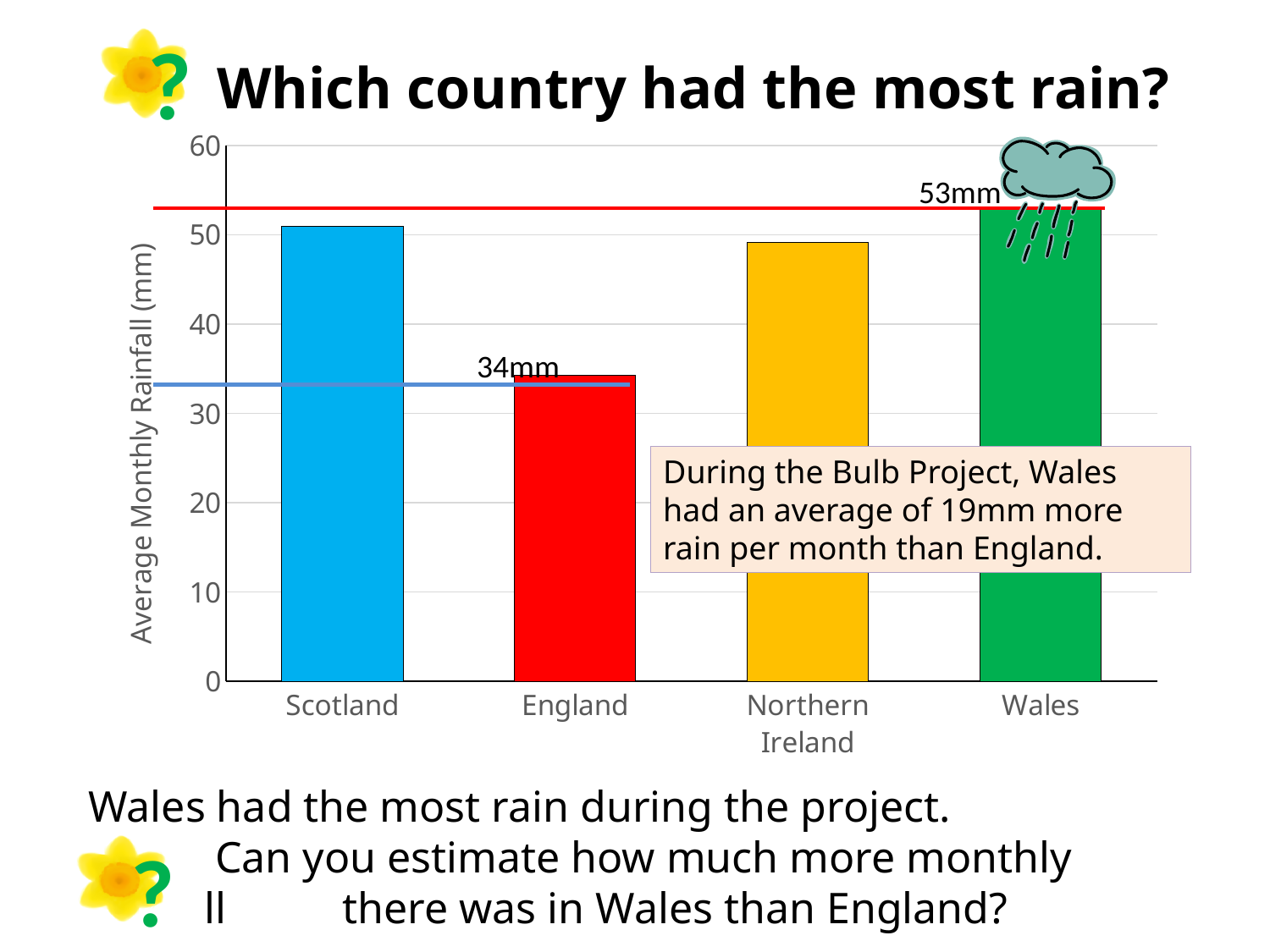
How much more average monthly rainfall did Wales have than England? 19mm Which has the larger average monthly rainfall, Scotland or Northern Ireland? Scotland Which country has the lowest average monthly rainfall? England Which has the larger average monthly rainfall, Scotland or England? Scotland Is the value for Scotland greater or less than 50? greater Is the value for Northern Ireland greater or less than 50? less What is the average monthly rainfall for Wales? 53mm What is the label on the vertical axis of the chart? Average Monthly Rainfall (mm) Which country has the highest average monthly rainfall? Wales What kind of chart is shown on the slide? Bar chart How many countries are shown on the chart? 4 What is the average monthly rainfall for England? 34mm